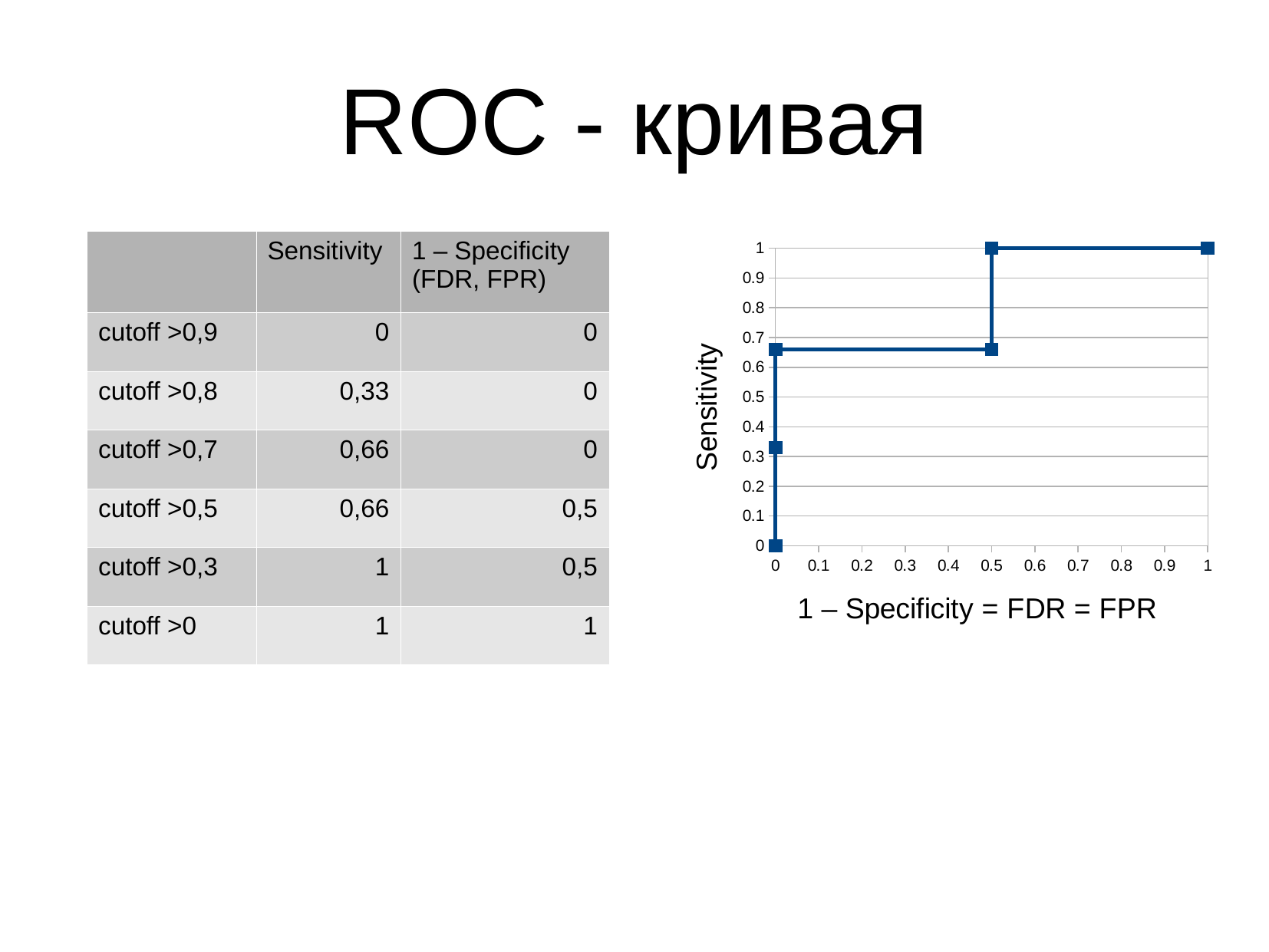
What is the highest Sensitivity value reached by the curve? 1 Is the Sensitivity of the lower point at x = 0.5 greater or less than 0.5? greater How many data points are marked on the ROC curve chart? 6 What is the title of the y axis of the chart? Sensitivity How many data points lie on the line x = 0? 3 What kind of chart is shown on the slide? line chart What is the x value of the rightmost point on the curve? 1 Is the Sensitivity of the second-lowest point at x = 0 greater or less than 0.4? less Does Sensitivity rise or fall as 1 – Specificity increases along the x axis? rises Which point has the higher Sensitivity: the upper point at x = 0.5 or the highest point at x = 0? the upper point at x = 0.5 What is the title of the x axis of the chart? 1 – Specificity = FDR = FPR What is the lowest Sensitivity value on the curve? 0